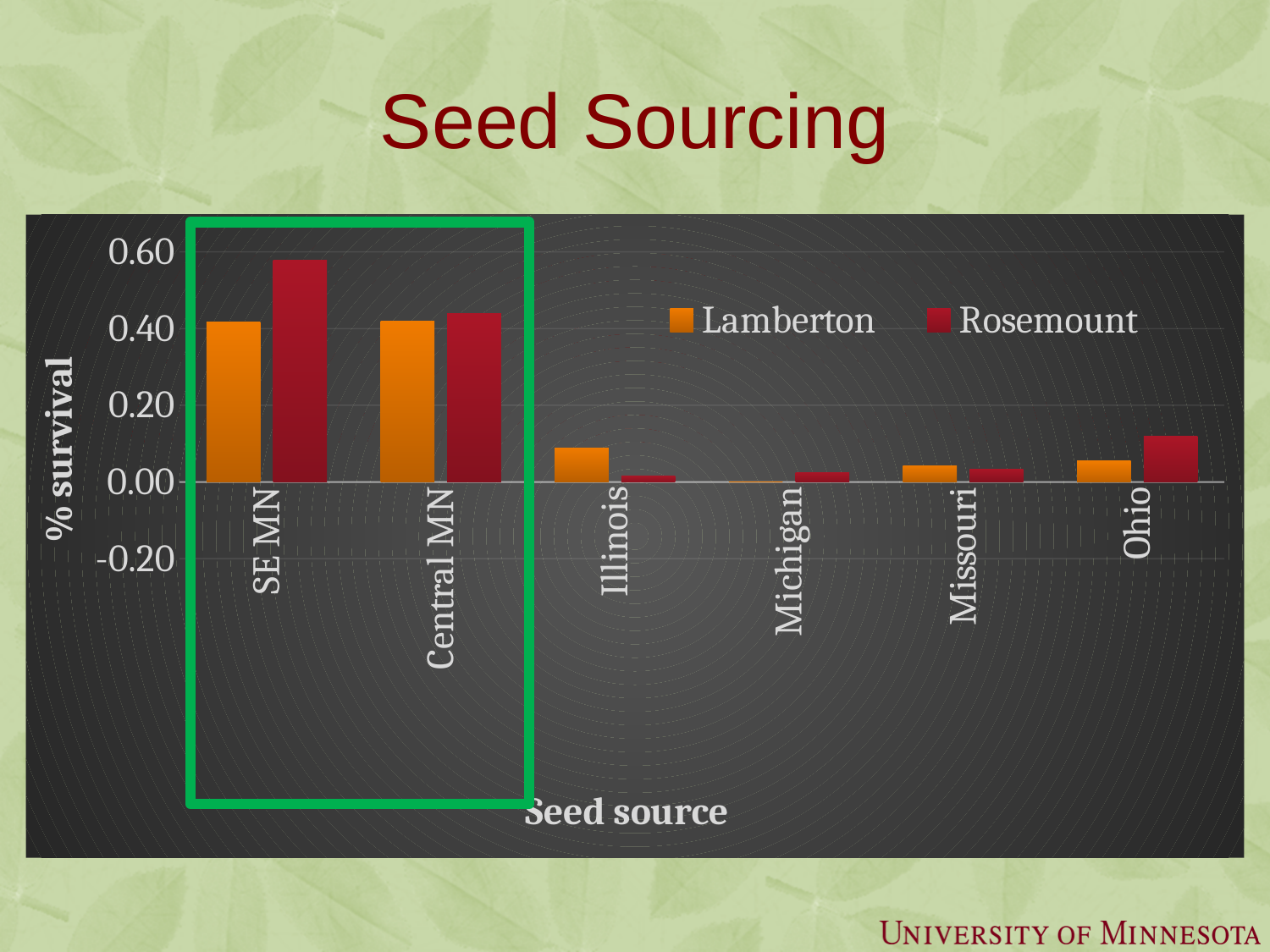
Which seed source has the highest Rosemount value? SE MN How many series does the legend list? 2 For Ohio, which series has the larger value, Lamberton or Rosemount? Rosemount Is the Rosemount value for SE MN greater or less than 0.40? greater For SE MN, which series has the larger value, Lamberton or Rosemount? Rosemount How many seed source categories are shown on the x axis? 6 What kind of chart is shown on the slide? bar chart What is the title of the y axis? % survival Is the Rosemount value for Ohio greater or less than 0.20? less Which seed source has the lowest Lamberton value? Michigan What is the title of the x axis? Seed source Is the Lamberton value for Illinois greater or less than 0.20? less